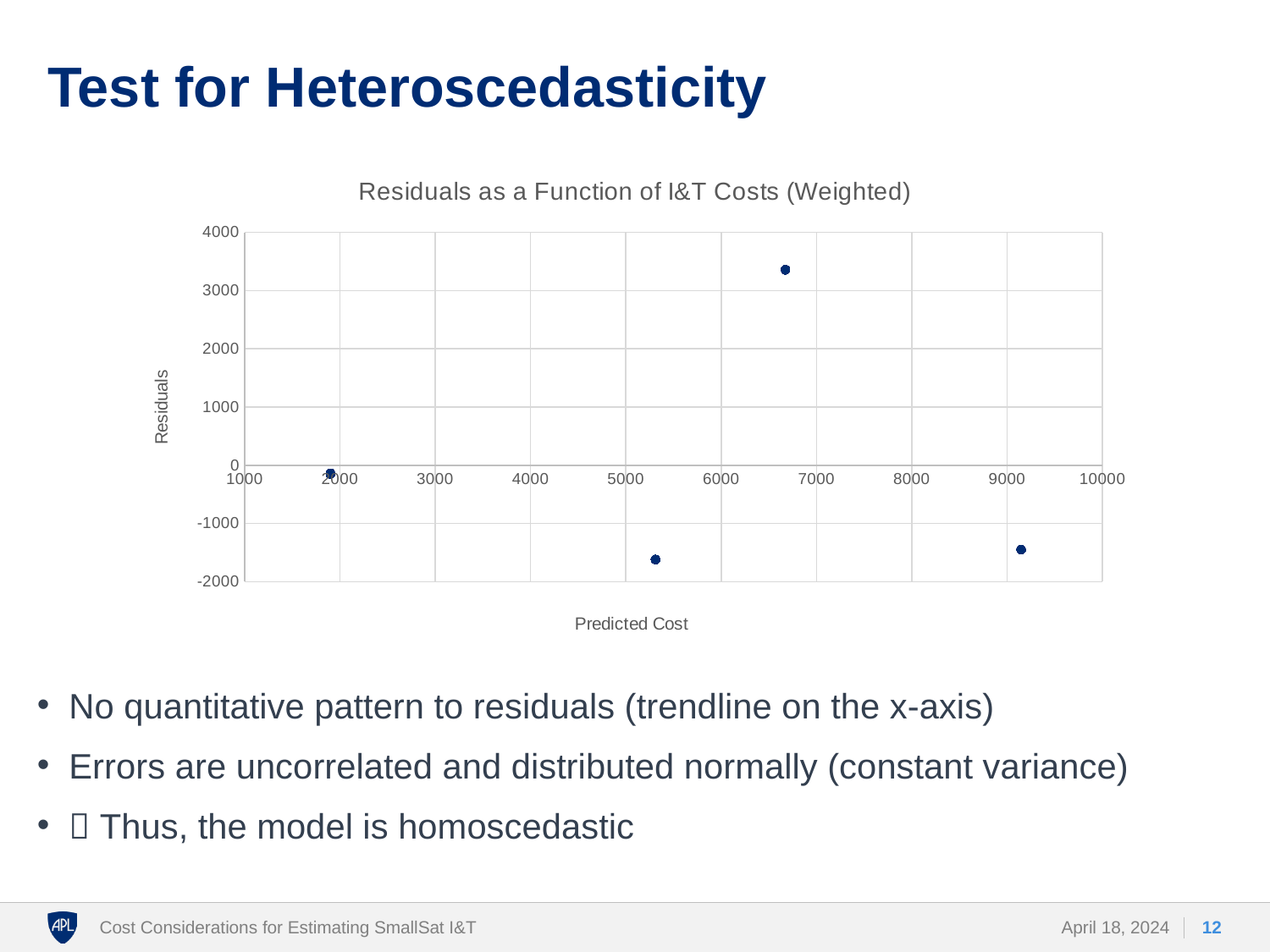
What is the highest value shown on the vertical axis? 4000 What is the label of the vertical axis? Residuals How many points have a residual above 0? 1 Which point has the lowest residual: the one near a predicted cost of 5300 or the one near 1900? The one near 5300 Which point has the highest residual: the one near a predicted cost of 6700 or the one near 9100? The one near 6700 Is the residual for the point plotted near a predicted cost of 6700 greater or less than 3000? greater Is the residual for the point plotted near a predicted cost of 1900 greater or less than 1000? less What kind of chart is shown on the slide? Scatter chart Is the residual for the point plotted near a predicted cost of 5300 greater or less than -1000? less What is the title of the chart? Residuals as a Function of I&T Costs (Weighted)